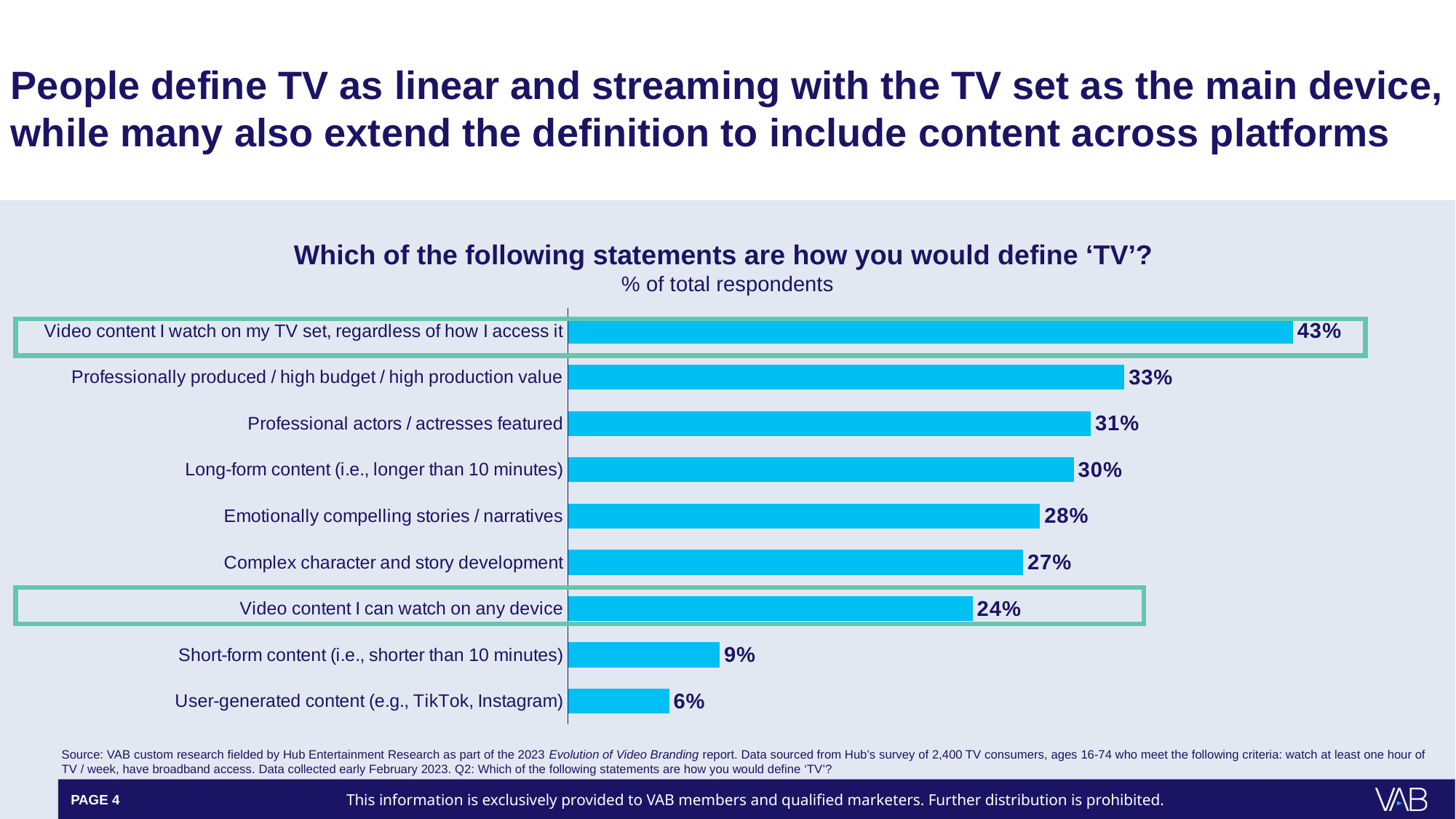
How many statements are shown in the chart? 9 What percentage of respondents define TV as 'Video content I watch on my TV set, regardless of how I access it'? 43% Which statement has the highest share of respondents? Video content I watch on my TV set, regardless of how I access it What percentage of respondents chose 'Video content I can watch on any device'? 24% Which is larger: 'Emotionally compelling stories / narratives' or 'Complex character and story development'? Emotionally compelling stories / narratives What kind of chart is shown on the slide? Bar chart What is the difference between 'Video content I watch on my TV set, regardless of how I access it' and 'Video content I can watch on any device'? 19% What is the difference between 'Professionally produced / high budget / high production value' and 'Professional actors / actresses featured'? 2% Which statement has the lowest share of respondents? User-generated content (e.g., TikTok, Instagram) Which is larger: 'Short-form content (i.e., shorter than 10 minutes)' or 'User-generated content (e.g., TikTok, Instagram)'? Short-form content (i.e., shorter than 10 minutes) What is the value for 'Long-form content (i.e., longer than 10 minutes)'? 30% What is the subtitle under the chart title indicating the unit of measurement? % of total respondents